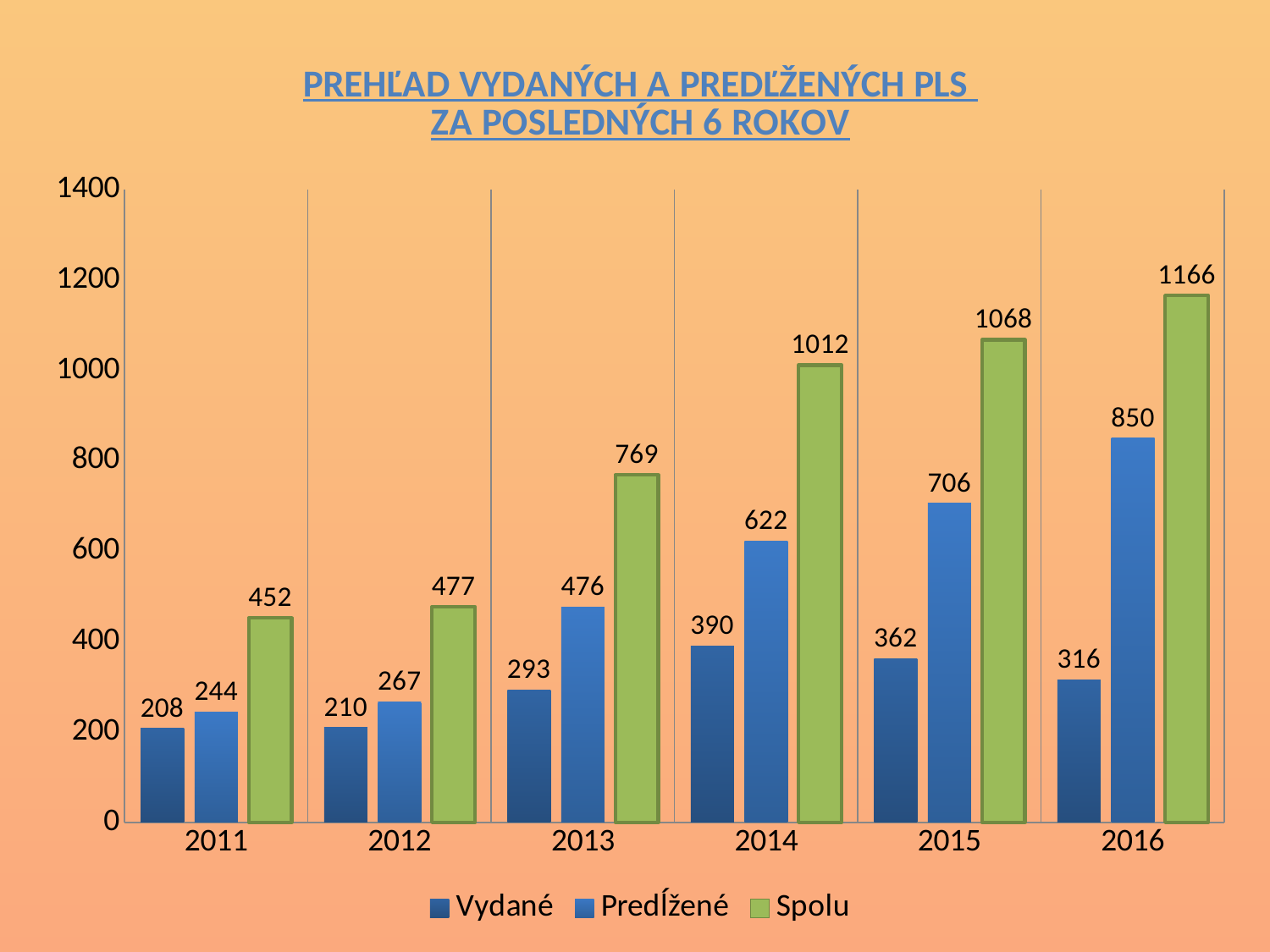
How many years are shown on the x axis? 6 What is the difference between the Spolu values for 2015 and 2014? 56 Does the Predĺžené series rise or fall from 2011 to 2016? rise What is the value of Spolu for 2013? 769 What is the value of Vydané for 2014? 390 How many series does the legend list? 3 What kind of chart is shown on the slide? bar chart Which year has the highest Spolu value? 2016 Which year has the lowest Vydané value? 2011 What is the value of Predĺžené for 2016? 850 Is the Spolu value for 2014 greater or less than 1000? greater Which is larger, Predĺžené in 2013 or Vydané in 2015? Predĺžené in 2013